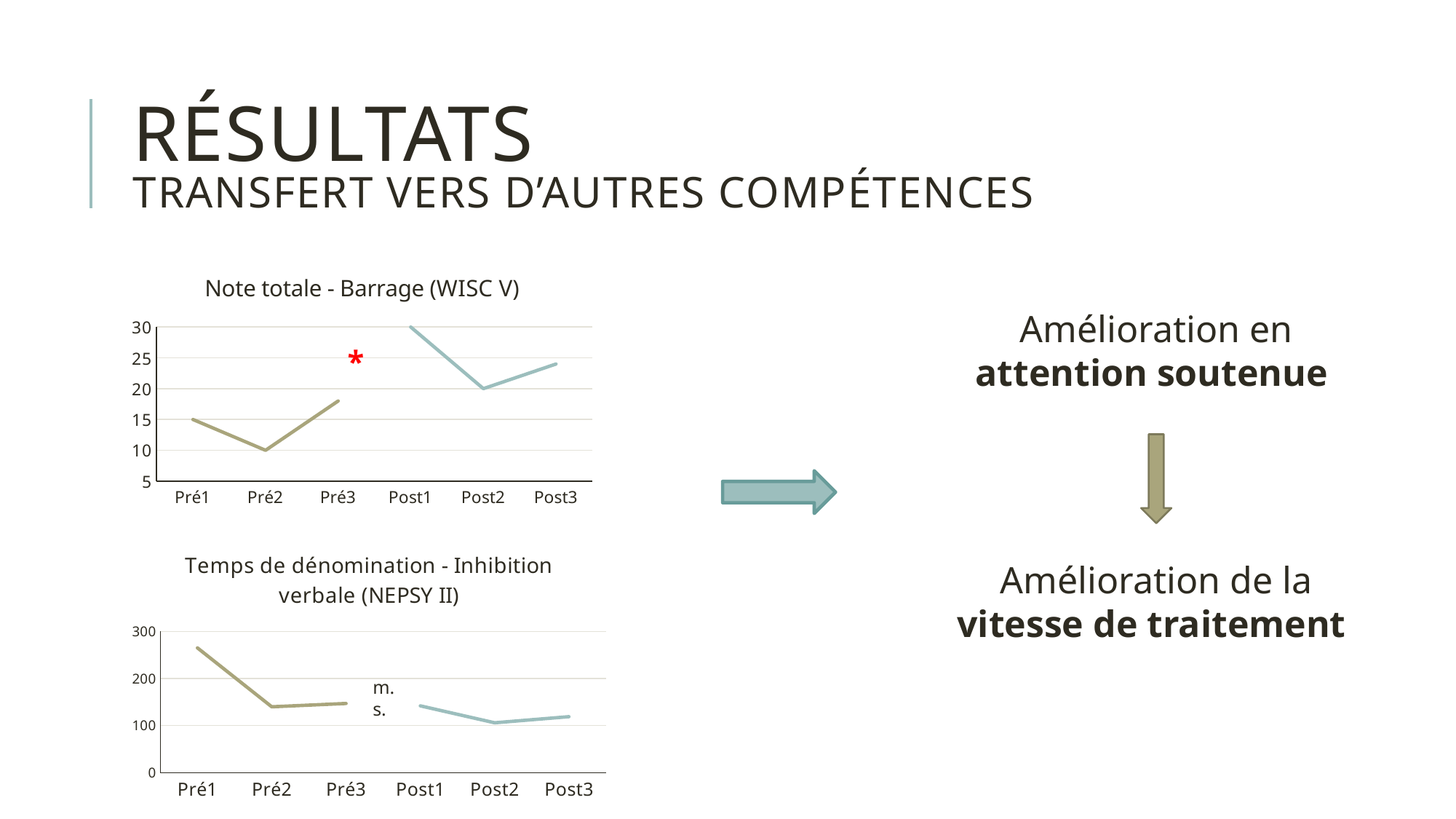
In the chart 'Note totale - Barrage (WISC V)', what is the value for Pré2? 10 In the chart 'Temps de dénomination - Inhibition verbale (NEPSY II)', do the values overall rise or fall from Pré1 to Post3? fall In the chart 'Temps de dénomination - Inhibition verbale (NEPSY II)', is the value for Post3 greater or less than 200? less In the chart 'Temps de dénomination - Inhibition verbale (NEPSY II)', which category has the highest value? Pré1 In the chart 'Note totale - Barrage (WISC V)', what is the value for Post1? 30 How many categories are shown on the x axis of the chart 'Temps de dénomination - Inhibition verbale (NEPSY II)'? 6 In the chart 'Temps de dénomination - Inhibition verbale (NEPSY II)', is the value for Pré1 greater or less than 200? greater In the chart 'Note totale - Barrage (WISC V)', which category has the lowest value? Pré2 In the chart 'Note totale - Barrage (WISC V)', is the value for Pré3 greater or less than 20? less In the chart 'Note totale - Barrage (WISC V)', which category has the highest value? Post1 What kind of chart is 'Note totale - Barrage (WISC V)'? line chart In the chart 'Note totale - Barrage (WISC V)', which is larger, the value for Post3 or the value for Pré1? Post3